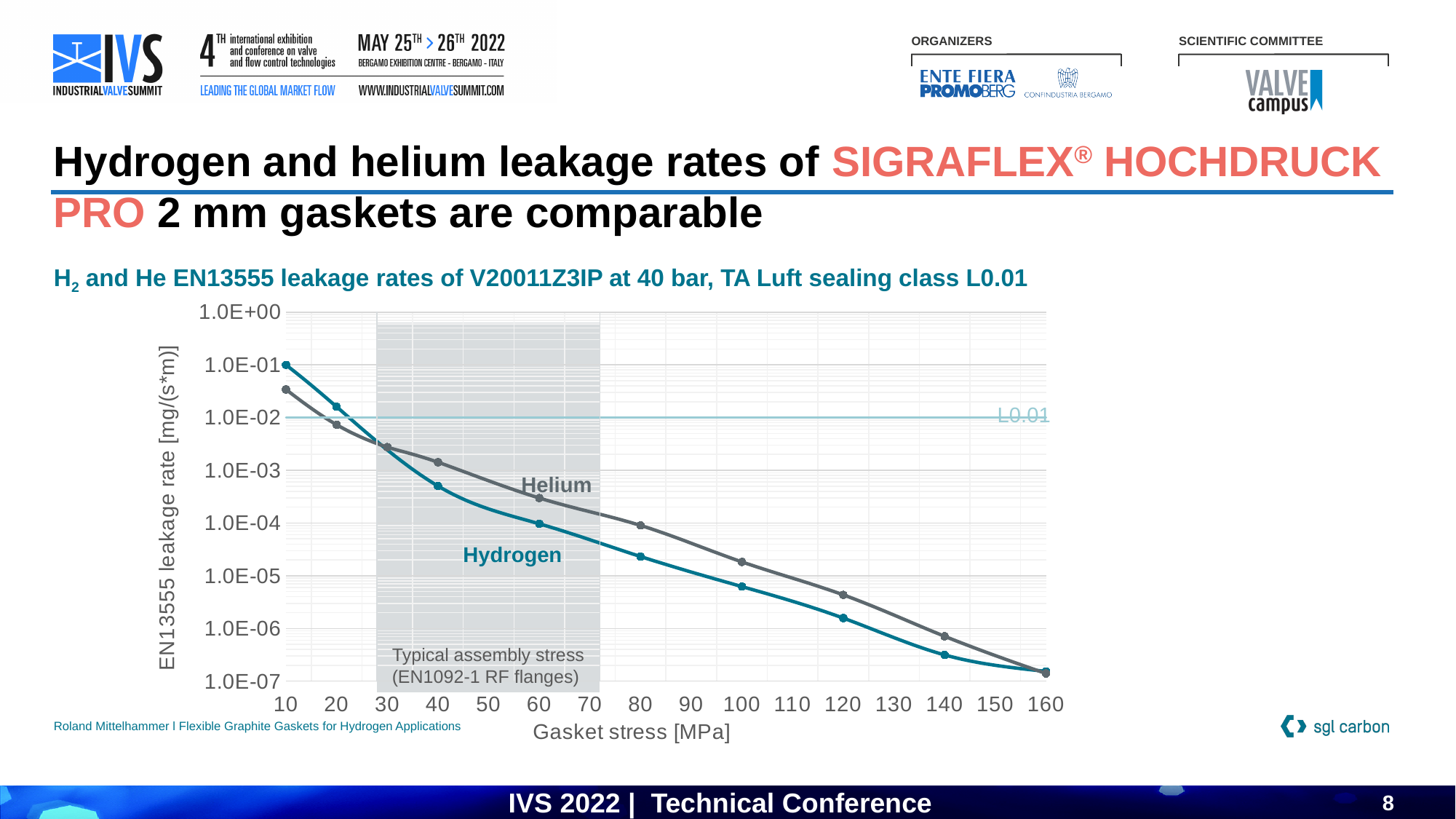
What is the label of the x axis of the chart? Gasket stress [MPa] Do the leakage rates rise or fall as gasket stress increases? fall Is the Helium leakage rate at 140 MPa greater or less than 1.0E-06? less How many data series are plotted in the chart? 2 Is the Hydrogen leakage rate at 80 MPa greater or less than 1.0E-04? less At which gasket stress is the leakage rate lowest for both series? 160 MPa What kind of chart is shown on the slide? line chart Is the Helium leakage rate at 60 MPa greater or less than 1.0E-04? greater At a gasket stress of 100 MPa, which series has the higher leakage rate, Hydrogen or Helium? Helium How many data points are plotted for the Hydrogen series? 9 At a gasket stress of 10 MPa, which series has the higher leakage rate, Hydrogen or Helium? Hydrogen